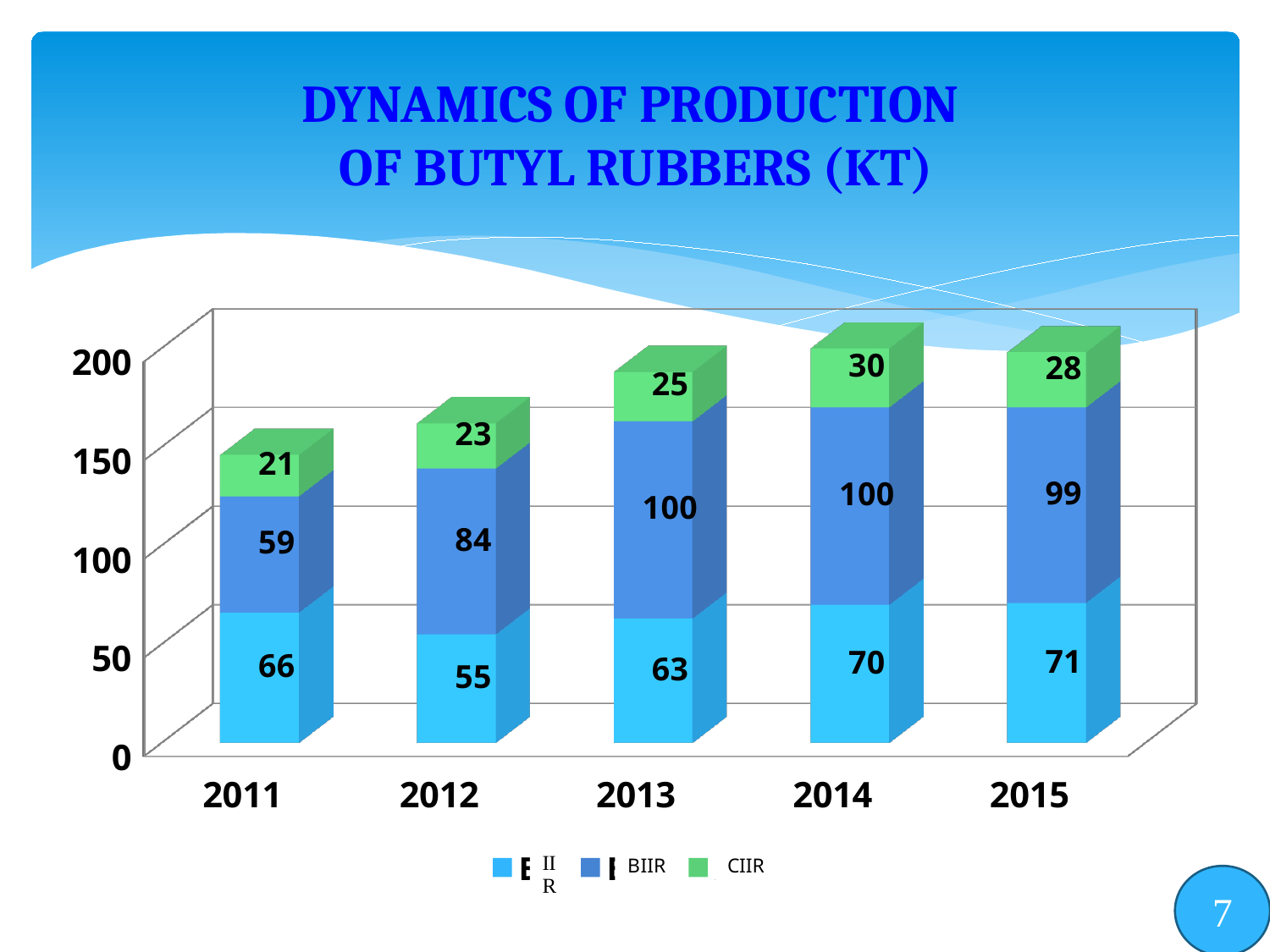
What is the total of the stacked bar for 2011? 146 What is the value of the bottom (light blue) segment of the 2012 bar? 55 What is the BIIR value for 2013? 100 How many series does the legend list? 3 How many years are shown on the x axis? 5 Does the CIIR value rise or fall from 2011 to 2014? Rise In which year is the BIIR value lowest? 2011 What is the CIIR value for 2011? 21 What is the difference between the CIIR value in 2014 and in 2011? 9 Which year has the larger BIIR value, 2012 or 2015? 2015 In which year is the CIIR value highest? 2014 What kind of chart is shown on the slide? Stacked bar chart